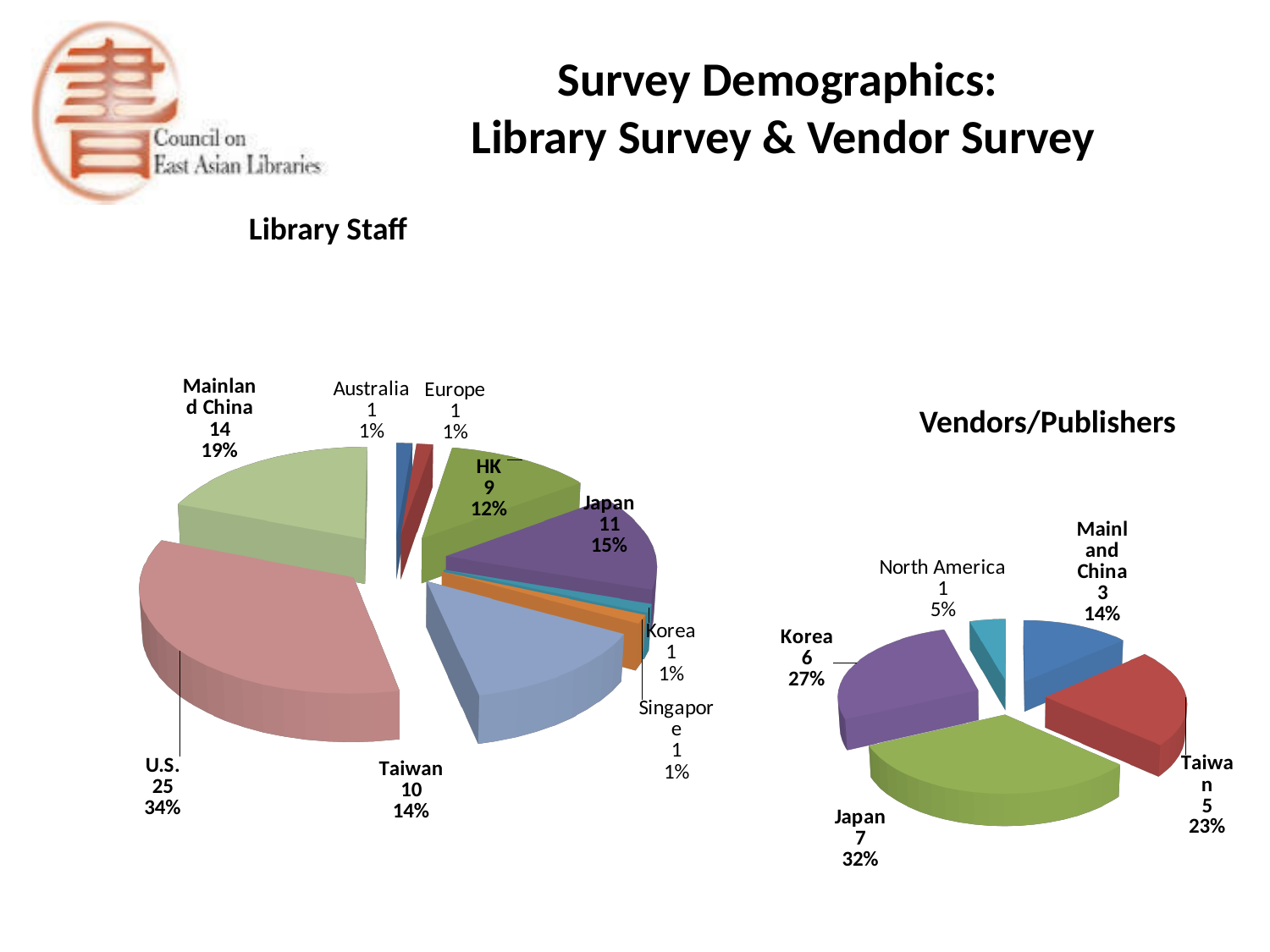
In the Vendors/Publishers chart, what is the difference between the Japan count and the Mainland China count? 4 In the Library Staff chart, which is larger, the HK slice or the Taiwan slice? Taiwan In the Vendors/Publishers chart, what percentage share does Taiwan have? 23% In the Library Staff chart, how many respondents are from the U.S.? 25 In the Library Staff chart, which region has the largest slice? U.S. In the Library Staff chart, what is the difference between the U.S. count and the Mainland China count? 11 What type of chart is the Vendors/Publishers chart? Pie chart How many categories are shown in the Vendors/Publishers chart? 5 In the Vendors/Publishers chart, how many respondents are from Korea? 6 In the Library Staff chart, what percentage share does Japan have? 15% How many categories are shown in the Library Staff chart? 9 In the Vendors/Publishers chart, which region has the smallest slice? North America